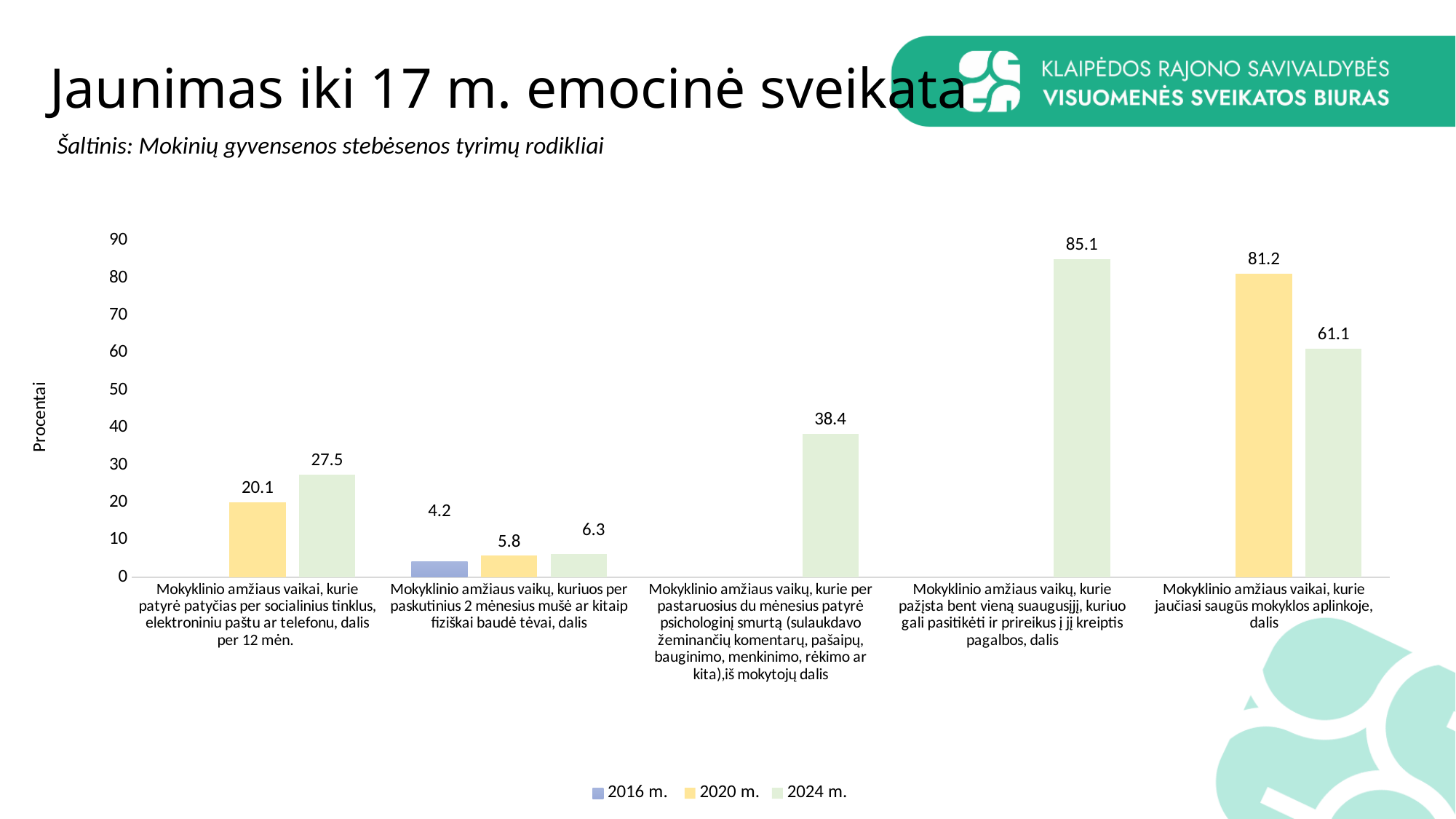
What is the difference between the 2020 m. and 2024 m. values for children who feel safe in the school environment? 20.1 Which category has the highest 2024 m. value? Mokyklinio amžiaus vaikų, kurie pažįsta bent vieną suaugusįjį, kuriuo gali pasitikėti ir prireikus į jį kreiptis pagalbos, dalis What kind of chart is shown on the slide? bar chart What is the 2024 m. value for children who feel safe in the school environment (jaučiasi saugūs mokyklos aplinkoje)? 61.1 How many series does the legend list? 3 Which category has the lowest 2024 m. value? Mokyklinio amžiaus vaikų, kuriuos per paskutinius 2 mėnesius mušė ar kitaip fiziškai baudė tėvai, dalis For children who experienced bullying via social networks, email or phone, which is larger: the 2020 m. value or the 2024 m. value? 2024 m. What is the 2016 m. value for children whose parents hit or otherwise physically punished them in the last 2 months? 4.2 How many categories are shown on the x axis? 5 What is the 2020 m. value for children who experienced bullying via social networks, email or phone in the last 12 months? 20.1 What is the label of the vertical axis? Procentai What is the 2024 m. value for children who experienced psychological violence from teachers in the last two months? 38.4